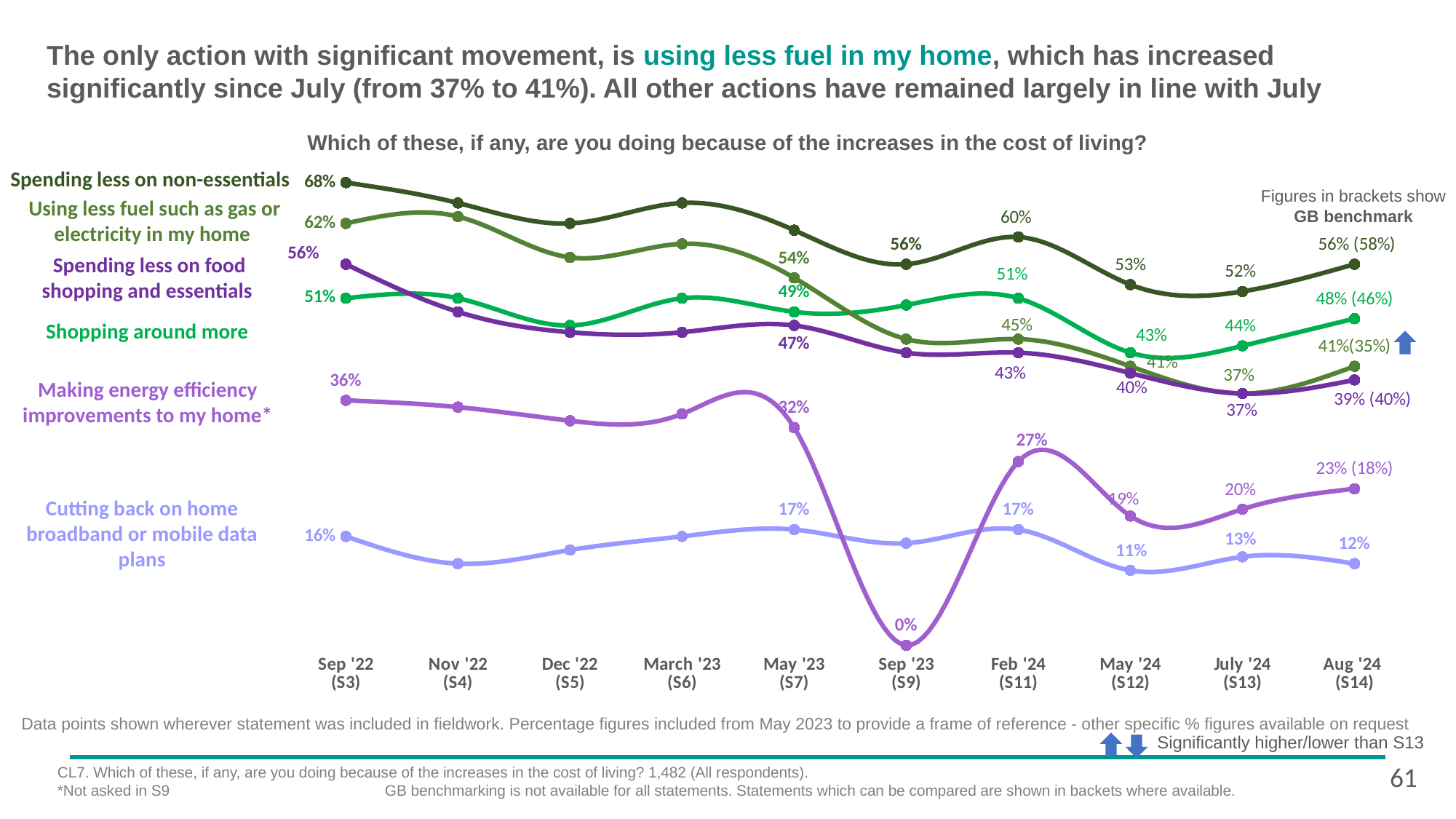
What is the value for 'Spending less on non-essentials' in Aug '24 (S14)? 56% By how many percentage points did 'Using less fuel such as gas or electricity in my home' change from July '24 to Aug '24? 4 percentage points What is the value for 'Making energy efficiency improvements to my home' in Sep '23 (S9)? 0% What kind of chart is shown on the slide? Line chart What is the value for 'Using less fuel such as gas or electricity in my home' in July '24 (S13)? 37% Which action has the lowest value in Aug '24 (S14)? Cutting back on home broadband or mobile data plans How many time points are shown along the x axis? 10 What is the value for 'Spending less on food shopping and essentials' in Feb '24 (S11)? 43% In Aug '24 (S14), which is larger: 'Shopping around more' or 'Spending less on food shopping and essentials'? Shopping around more How many series (actions) are plotted on the chart? 6 Which action has the highest value in Sep '22 (S3)? Spending less on non-essentials What is the GB benchmark figure shown in brackets for 'Using less fuel such as gas or electricity in my home' in Aug '24? 35%